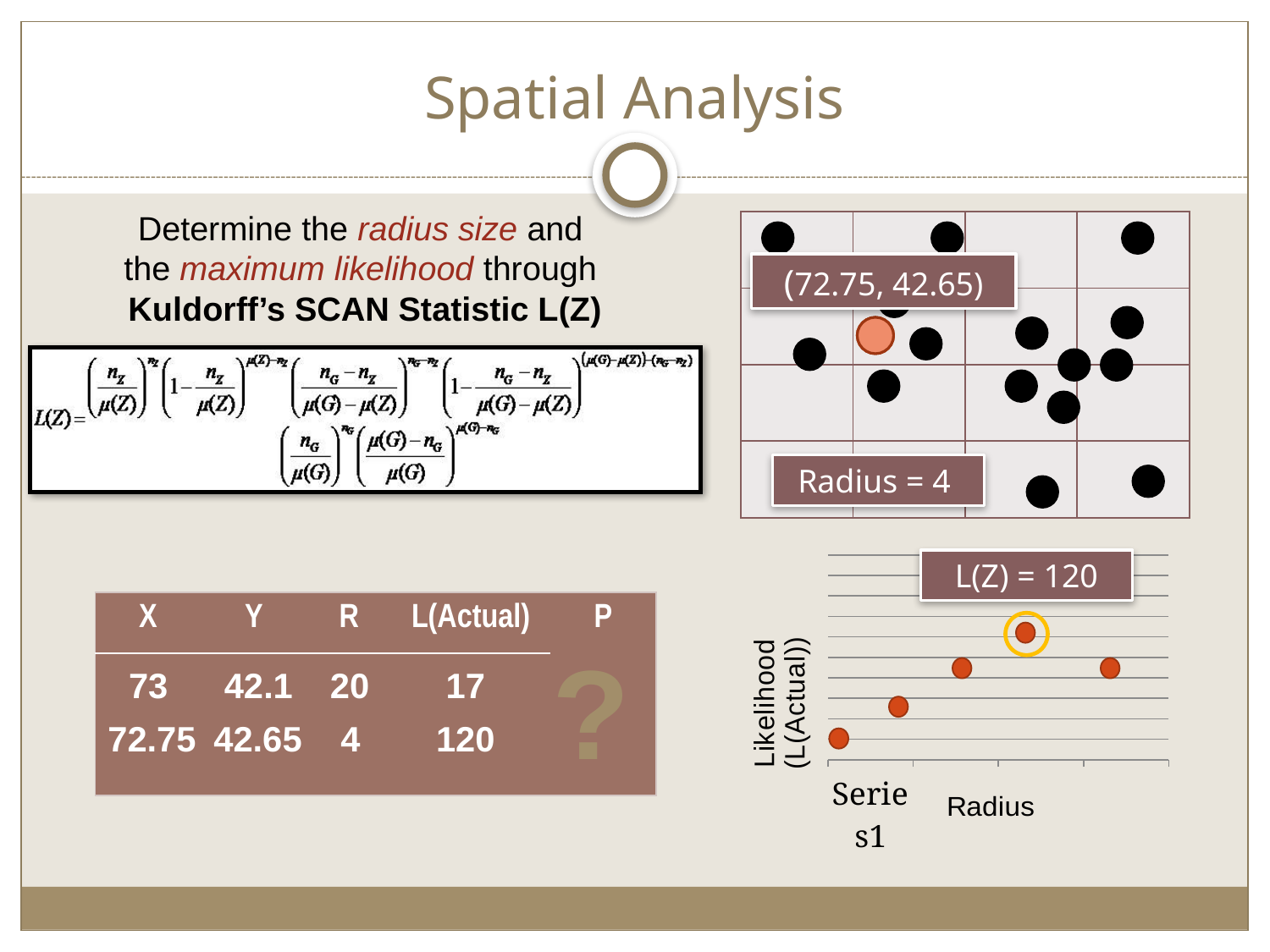
In the scatter chart, which point has the highest likelihood value? The third (circled) point In the scatter chart, which is higher: the second point or the fourth point? The fourth point In the scatter chart, do the values rise or fall from the first point to the third point along the x axis? Rise What is the title of the y axis of the scatter chart? Likelihood (L(Actual)) What kind of chart is shown at the bottom right of the slide? Scatter chart In the scatter chart, do the values rise or fall from the third point to the fifth point along the x axis? Fall In the scatter chart, which is higher: the first point or the fifth point? The fifth point How many data points are plotted in the scatter chart at the bottom right? 5 How many series does the legend of the scatter chart list? 1 What is the title of the x axis of the scatter chart? Radius In the scatter chart, what L(Z) value does the callout give for the circled point? 120 In the scatter chart, which point has the lowest likelihood value? The first (leftmost) point